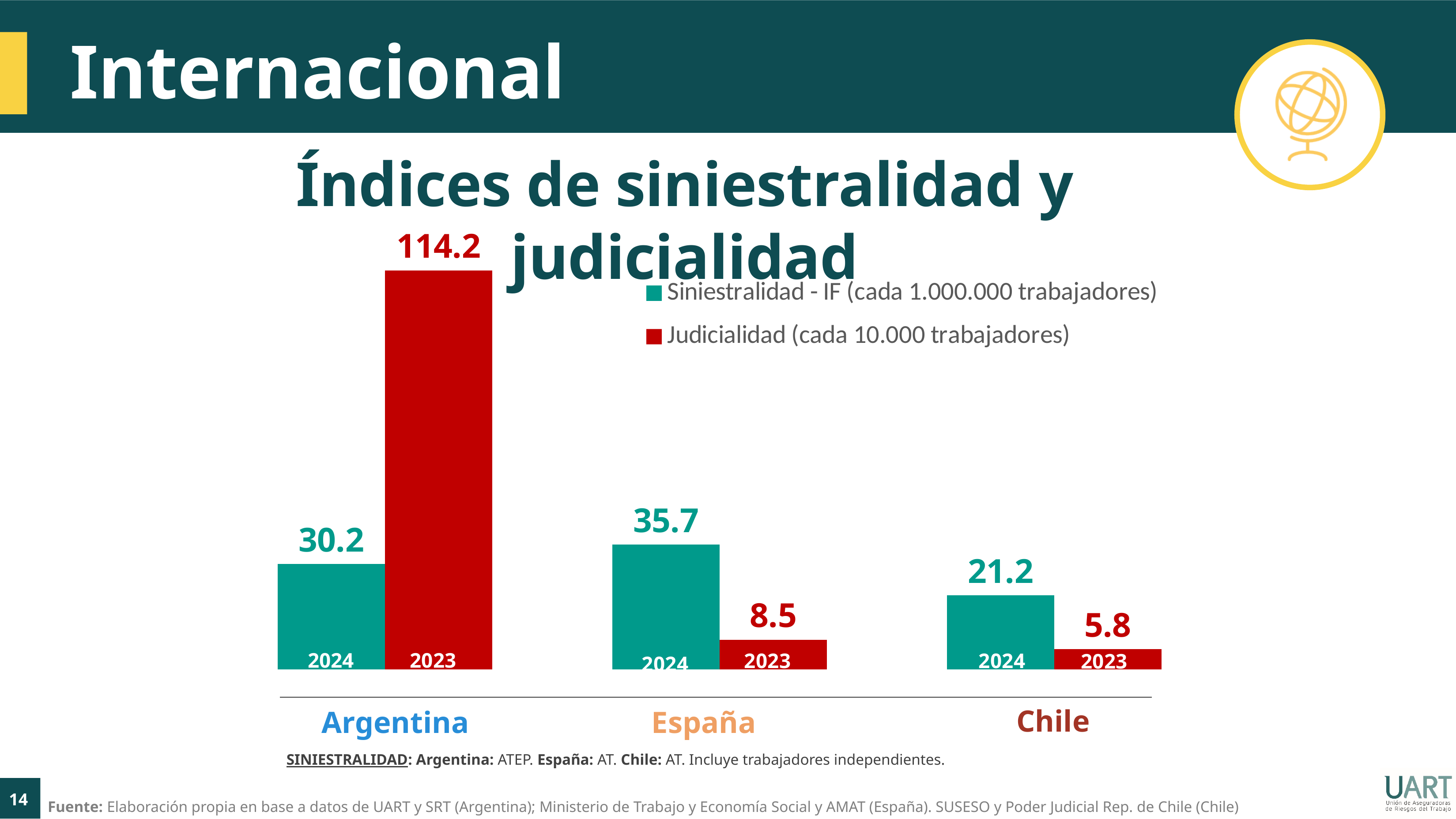
How many series does the chart legend list? 2 Which year is labelled on the Judicialidad bars? 2023 What is the difference between the Judicialidad values for Argentina and España? 105.7 What is the Siniestralidad - IF value for España? 35.7 How many countries are shown on the x axis of the chart? 3 What is the Judicialidad value for Argentina? 114.2 What is the Judicialidad value for Chile? 5.8 What type of chart is shown on the slide? Bar chart Which country has the lowest Judicialidad value? Chile Which country has the highest Siniestralidad - IF value? España Which is larger, the Siniestralidad - IF value for Chile or the Judicialidad value for Chile? Siniestralidad - IF value for Chile What is the Siniestralidad - IF value for Argentina? 30.2